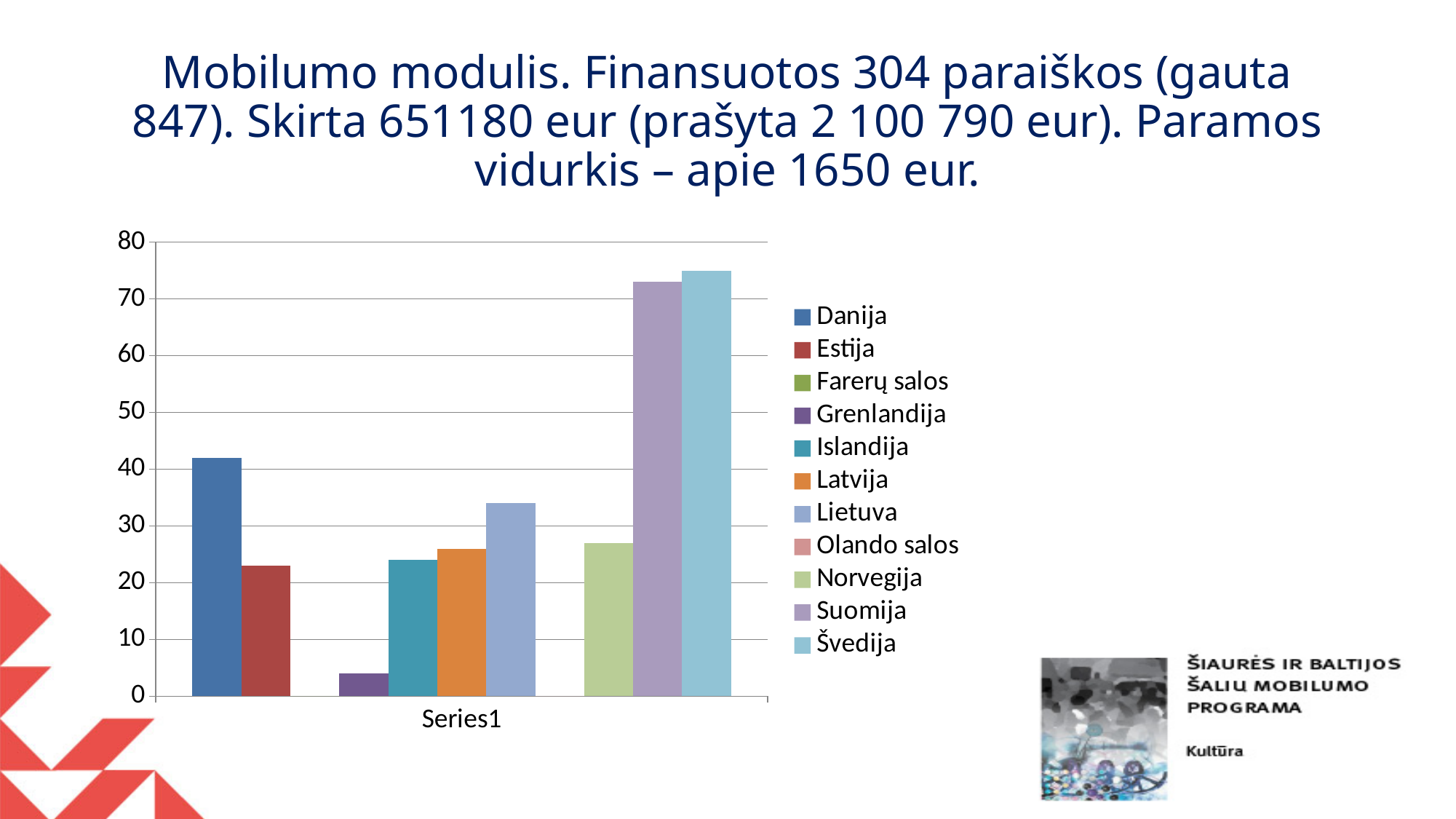
Is the value for Danija greater or less than 30? greater How many entries does the chart legend list? 11 Which is larger, the value for Lietuva or the value for Latvija? Lietuva Which is larger, the value for Danija or the value for Estija? Danija What label is shown on the horizontal axis of the chart? Series1 Is the value for Suomija greater or less than 70? greater Which is larger, the value for Suomija or the value for Lietuva? Suomija Is the value for Lietuva greater or less than 30? greater What kind of chart is shown on the slide? bar chart